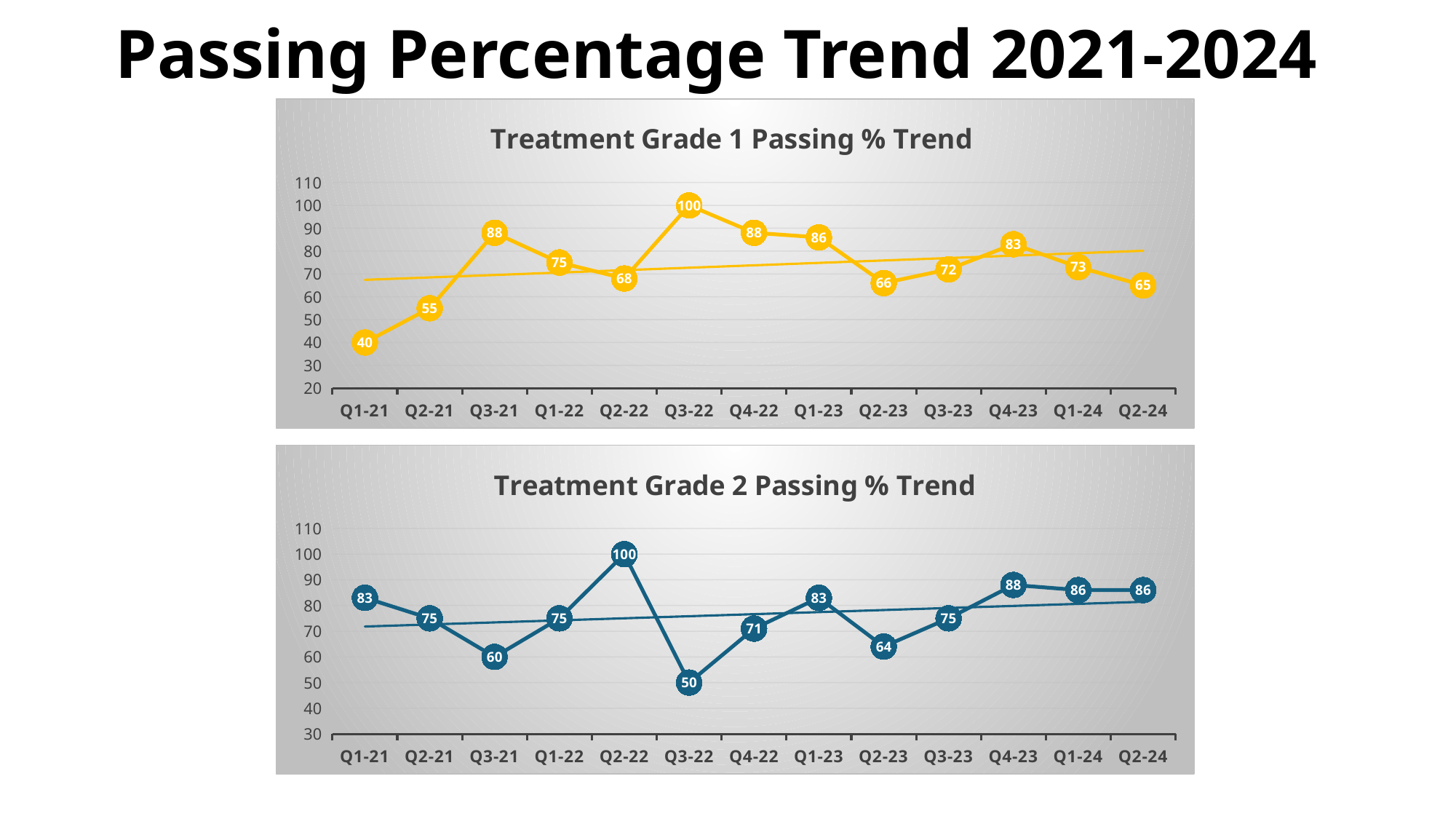
In the Treatment Grade 1 Passing % Trend chart, what is the difference between the values for Q3-22 and Q1-21? 60 In the Treatment Grade 2 Passing % Trend chart, which quarter has the highest value? Q2-22 In the Treatment Grade 2 Passing % Trend chart, which quarter has the lowest value? Q3-22 How many quarters are plotted on the x axis of the Treatment Grade 1 Passing % Trend chart? 13 In the Treatment Grade 2 Passing % Trend chart, what is the difference between the values for Q4-23 and Q2-23? 24 In the Treatment Grade 1 Passing % Trend chart, what is the value for Q3-21? 88 What kind of chart is the Treatment Grade 2 Passing % Trend chart? Line chart What is the title of the top chart on the slide? Treatment Grade 1 Passing % Trend In the Treatment Grade 1 Passing % Trend chart, which quarter has the lowest value? Q1-21 In the Treatment Grade 2 Passing % Trend chart, which is larger, the value for Q1-21 or the value for Q3-21? Q1-21 In the Treatment Grade 1 Passing % Trend chart, which quarter has the highest value? Q3-22 In the Treatment Grade 2 Passing % Trend chart, what is the value for Q3-22? 50